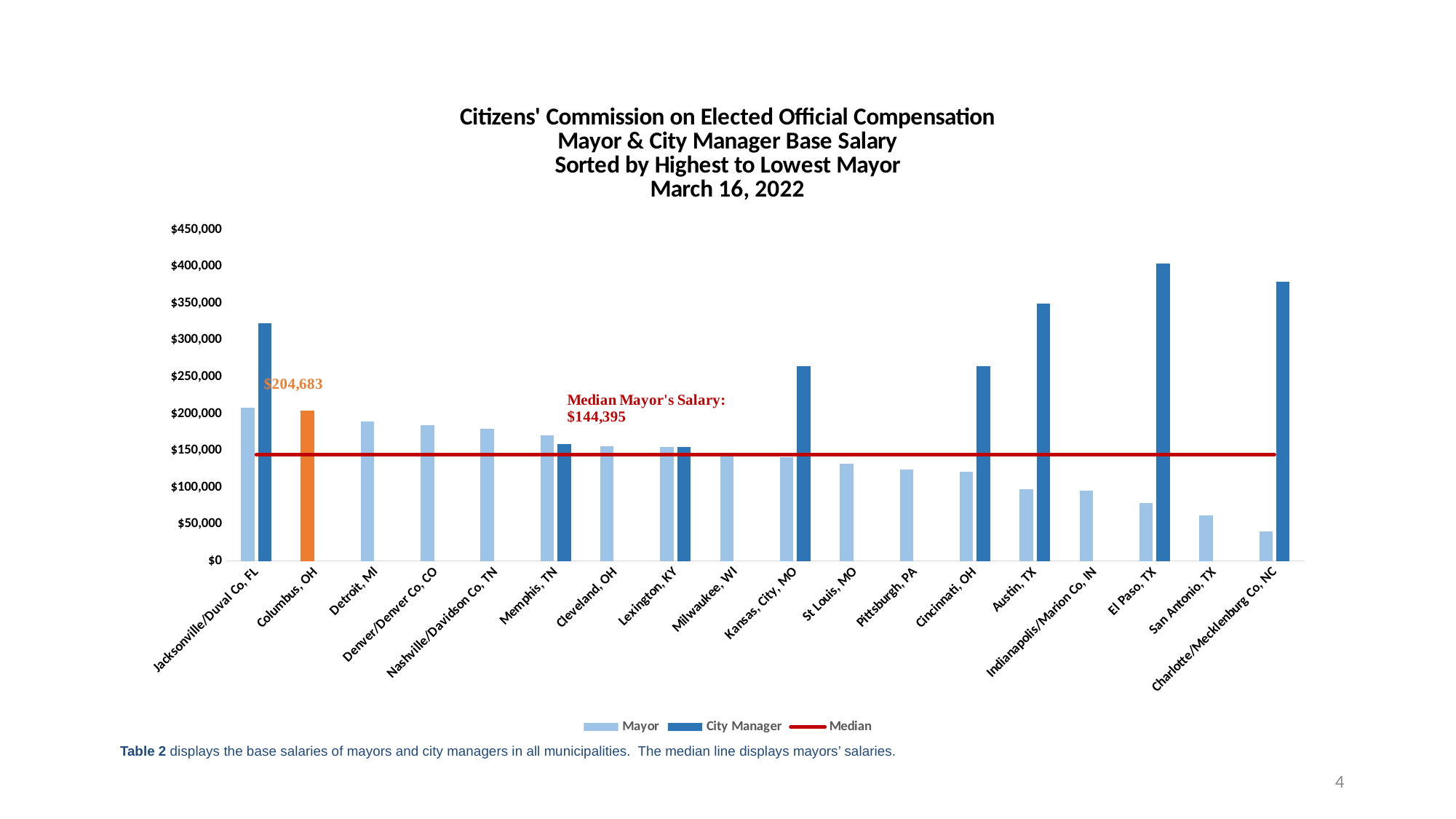
What is the median mayor's salary shown on the chart? $144,395 Is the City Manager salary for Jacksonville/Duval Co, FL greater or less than $300,000? greater Which municipality has the lowest Mayor base salary? Charlotte/Mecklenburg Co, NC Do the Mayor salaries rise or fall from left to right along the x axis? Fall What is the base salary shown for the Mayor of Columbus, OH? $204,683 Is the Mayor salary for Charlotte/Mecklenburg Co, NC greater or less than $50,000? less What kind of chart is shown on the slide? Combination bar and line chart How many entries does the legend list? 3 Is the Mayor salary for Pittsburgh, PA greater or less than $150,000? less How many municipalities are shown on the x axis? 18 Which municipality has the highest City Manager base salary? El Paso, TX Which is larger: the City Manager salary for Austin, TX or for Charlotte/Mecklenburg Co, NC? Charlotte/Mecklenburg Co, NC